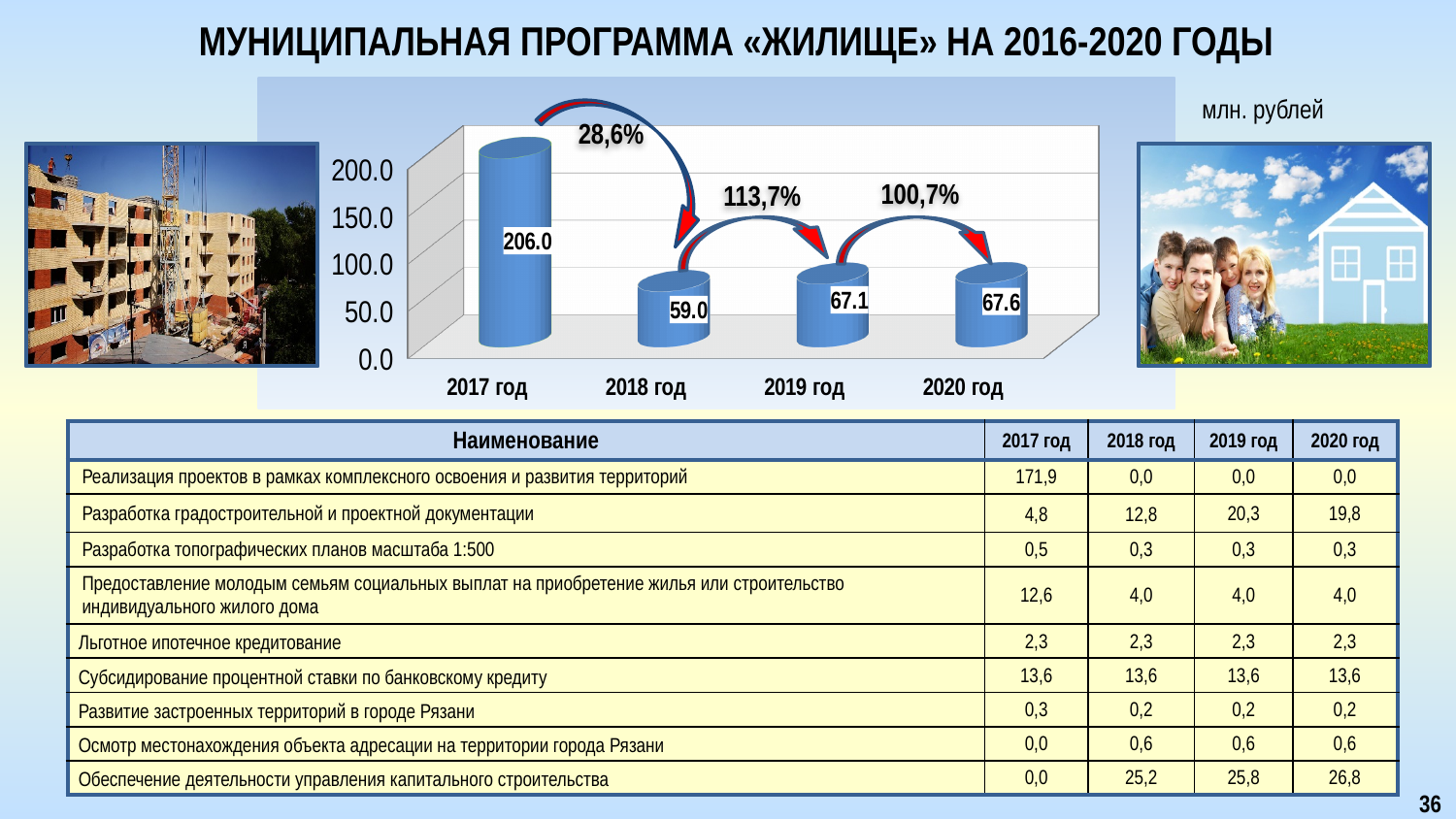
What is the value for 2019 год on the chart? 67.1 What is the value for 2017 год on the chart? 206.0 What is the difference between the values for 2019 год and 2018 год? 8.1 What kind of chart is shown on the slide? bar chart How many years are shown on the chart's x axis? 4 What is the value for 2020 год on the chart? 67.6 What is the difference between the values for 2017 год and 2018 год? 147.0 What is the value for 2018 год on the chart? 59.0 Which is larger, the value for 2017 год or the value for 2020 год? 2017 год Which year has the lowest value on the chart? 2018 год Which year has the highest value on the chart? 2017 год What percentage label is shown on the arrow between 2017 год and 2018 год? 28,6%